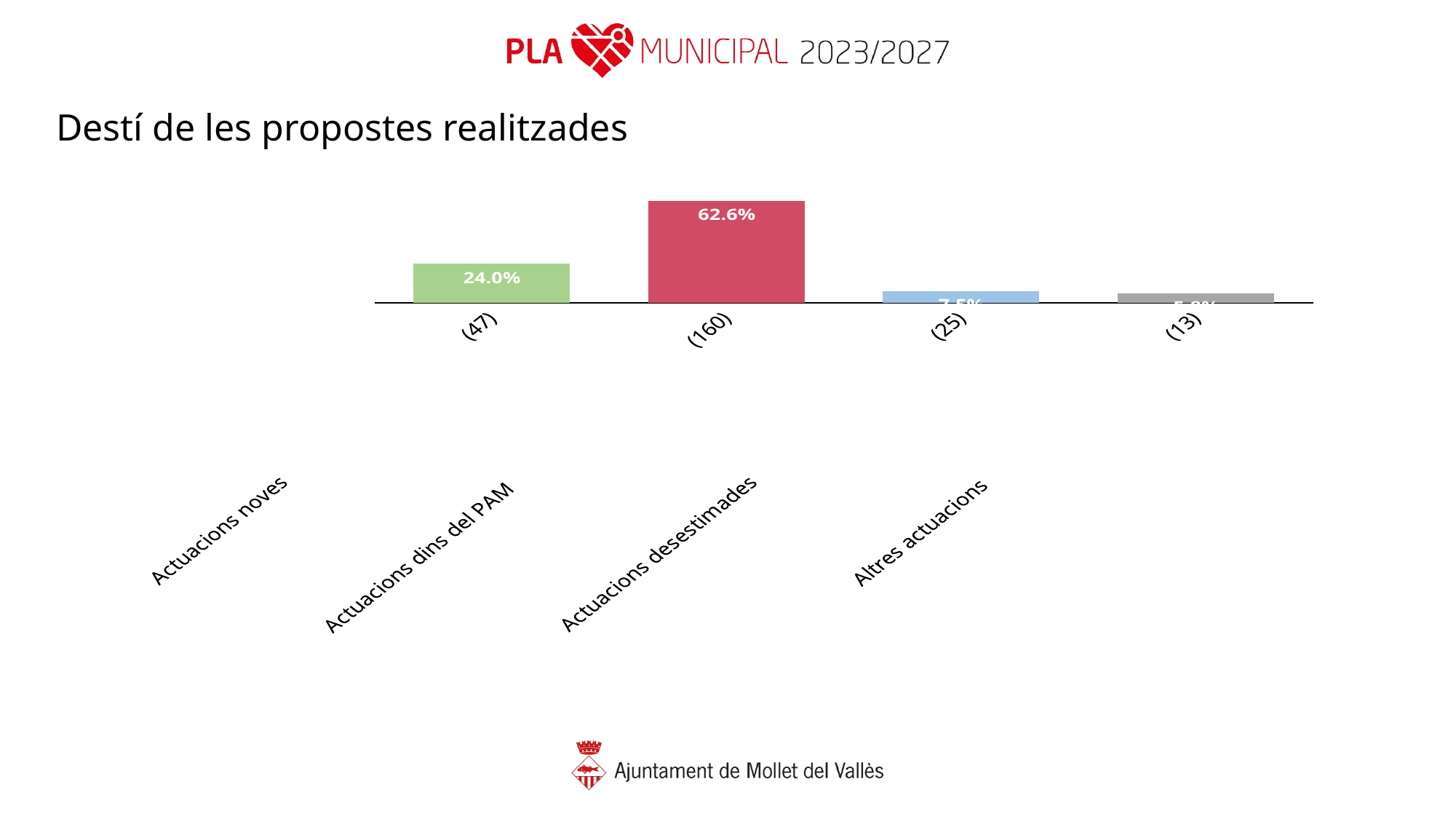
What type of chart is shown on the slide? Bar chart How many more proposals (numbers in parentheses) are there for Actuacions dins del PAM than for Actuacions noves? 113 Which is larger, the bar for Actuacions noves or the bar for Actuacions desestimades? Actuacions noves Which category has the lowest bar? Altres actuacions Which category has the highest bar? Actuacions dins del PAM What number in parentheses is shown under the bar for Actuacions dins del PAM? 160 What number in parentheses is shown under the bar for Actuacions desestimades? 25 What percentage is shown for Actuacions noves? 24.0% What is the difference in percentage points between Actuacions dins del PAM and Actuacions noves? 38.6 How many categories are plotted in the chart? 4 What percentage is shown for Actuacions dins del PAM? 62.6% What number in parentheses is shown under the bar for Altres actuacions? 13